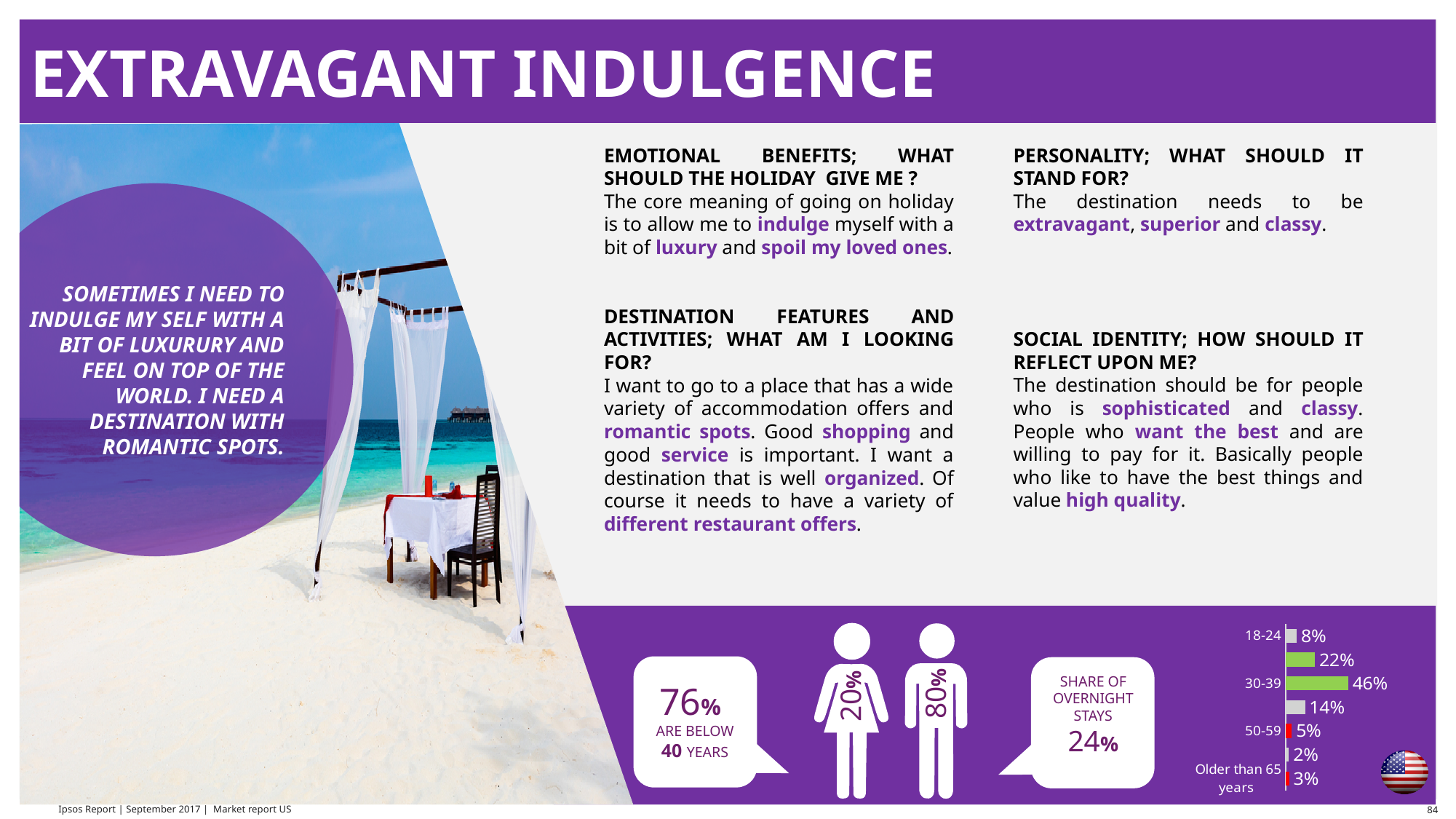
In the age-group bar chart, which age group has the highest value? 30-39 In the age-group bar chart, what is the difference between the 30-39 value and the 18-24 value? 38% In the age-group bar chart, what is the lowest value shown on any bar? 2% How many bars are shown in the age-group bar chart? 7 In the age-group bar chart, what colour is the bar for the 30-39 age group? green In the age-group bar chart, what is the value for the 18-24 age group? 8% What kind of chart is shown at the bottom right of the slide? bar chart In the age-group bar chart, what is the value for people older than 65 years? 3% In the age-group bar chart, what is the difference between the 18-24 value and the 50-59 value? 3% In the age-group bar chart, what is the value for the 30-39 age group? 46% In the age-group bar chart, what is the value for the 50-59 age group? 5% In the age-group bar chart, which is larger: the value for 18-24 or the value for 50-59? 18-24